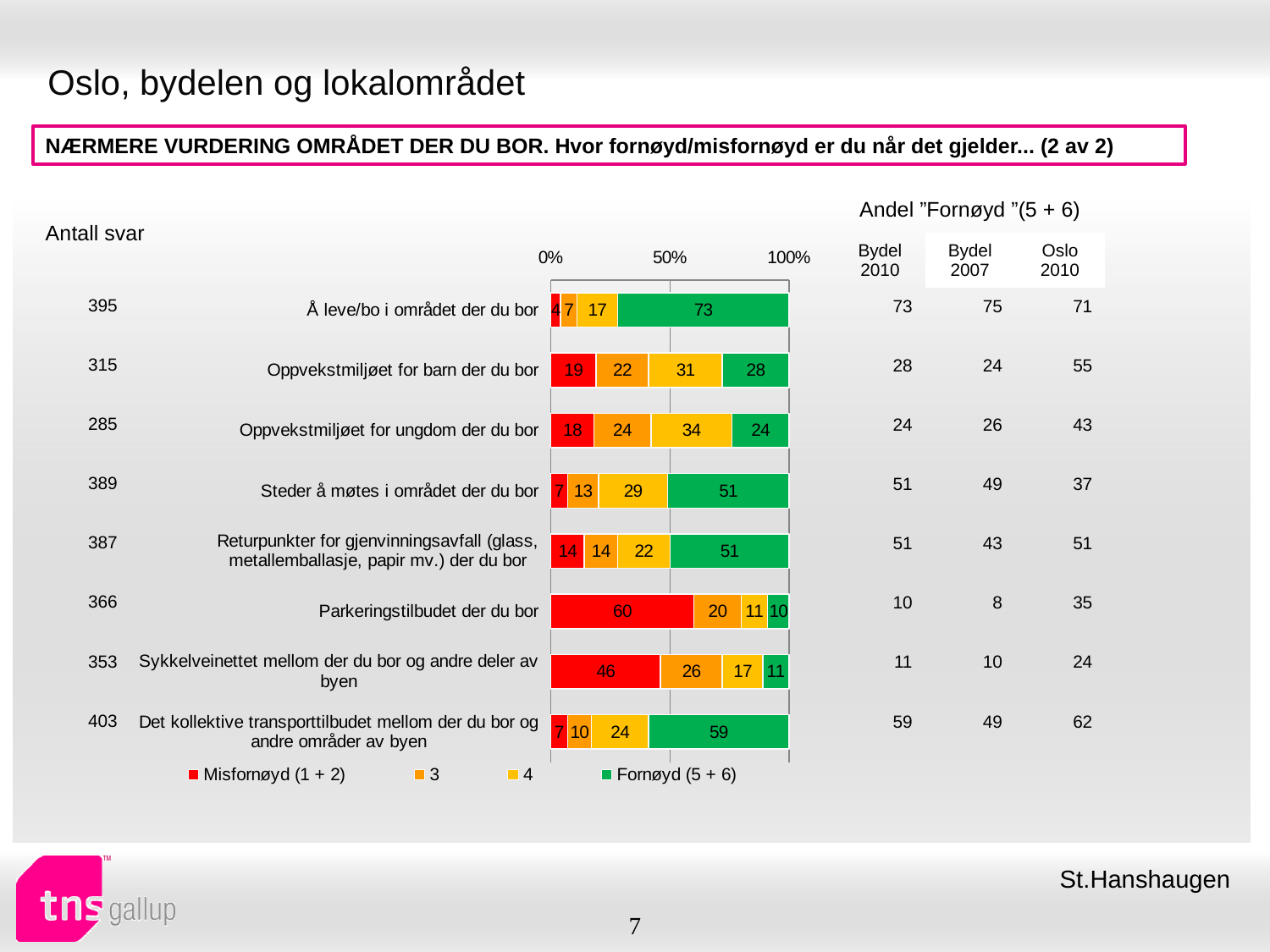
What is the Fornøyd (5 + 6) value for "Å leve/bo i området der du bor"? 73 Which is larger: the Fornøyd (5 + 6) value for "Oppvekstmiljøet for barn der du bor" or for "Det kollektive transporttilbudet mellom der du bor og andre områder av byen"? Det kollektive transporttilbudet mellom der du bor og andre områder av byen What kind of chart is shown on the slide? Stacked bar chart How many series does the chart legend list? 4 Which category has the lowest Fornøyd (5 + 6) value? Parkeringstilbudet der du bor What is the Misfornøyd (1 + 2) value for "Parkeringstilbudet der du bor"? 60 What colour represents the Fornøyd (5 + 6) series in the chart? Green How many categories (rows) are plotted in the chart? 8 What is the difference between the Misfornøyd (1 + 2) values for "Parkeringstilbudet der du bor" and "Sykkelveinettet mellom der du bor og andre deler av byen"? 14 Which category has the highest Fornøyd (5 + 6) value? Å leve/bo i området der du bor What is the value of series "4" for "Oppvekstmiljøet for ungdom der du bor"? 34 What is the total of the stacked bar for "Steder å møtes i området der du bor"? 100